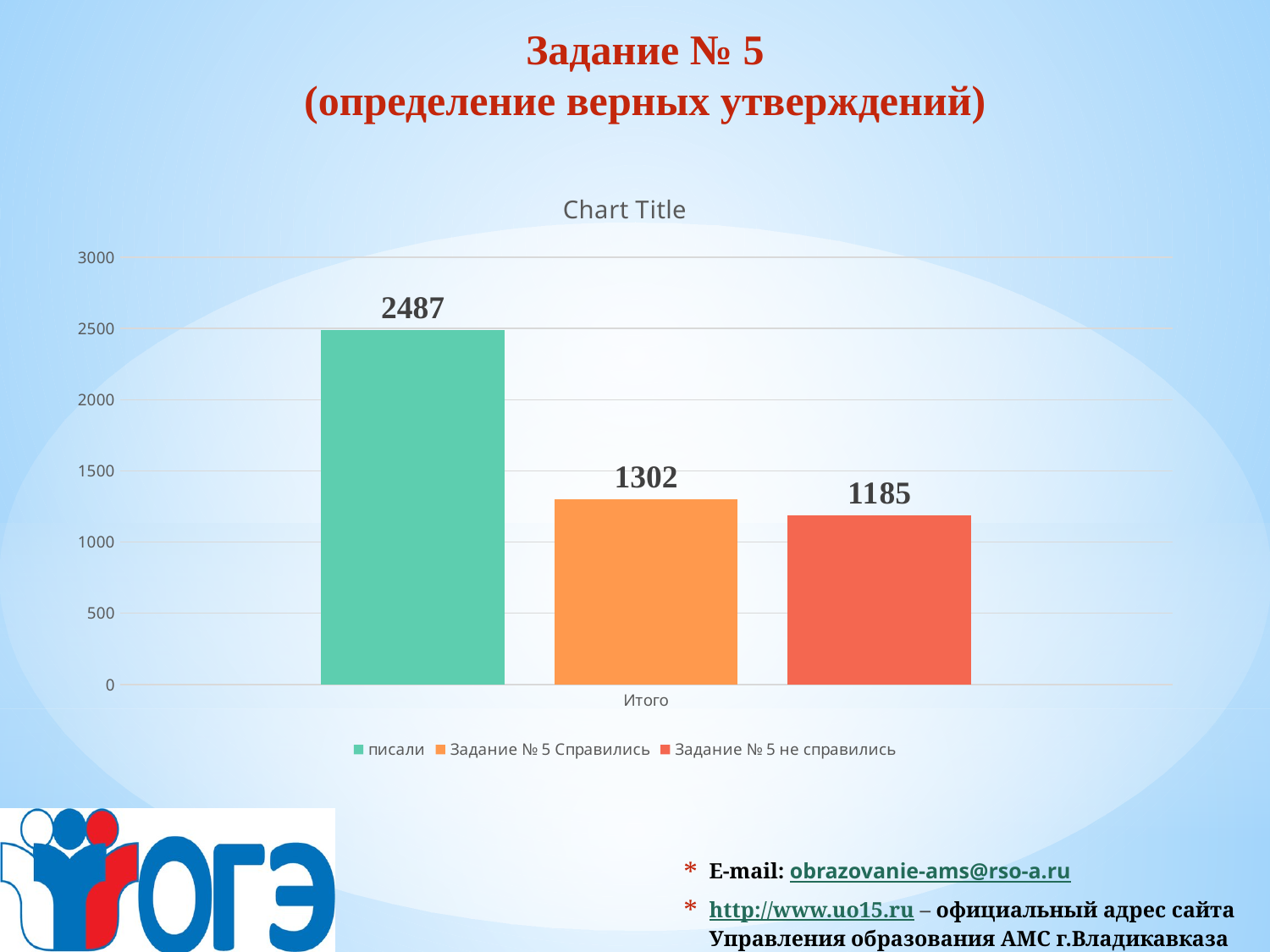
How many series does the legend list? 3 Which series has the highest value? писали What is the value for the series "Задание № 5 не справились"? 1185 What is the difference between the values for "писали" and "Задание № 5 Справились"? 1185 Is the value for "писали" greater or less than 2000? greater Which is larger: the value for "Задание № 5 Справились" or for "Задание № 5 не справились"? Задание № 5 Справились Which series has the lowest value? Задание № 5 не справились What is the value for the series "Задание № 5 Справились"? 1302 What is the category label shown on the x axis? Итого What is the difference between the values for "Задание № 5 Справились" and "Задание № 5 не справились"? 117 What is the value for the series "писали"? 2487 What kind of chart is shown on the slide? bar chart